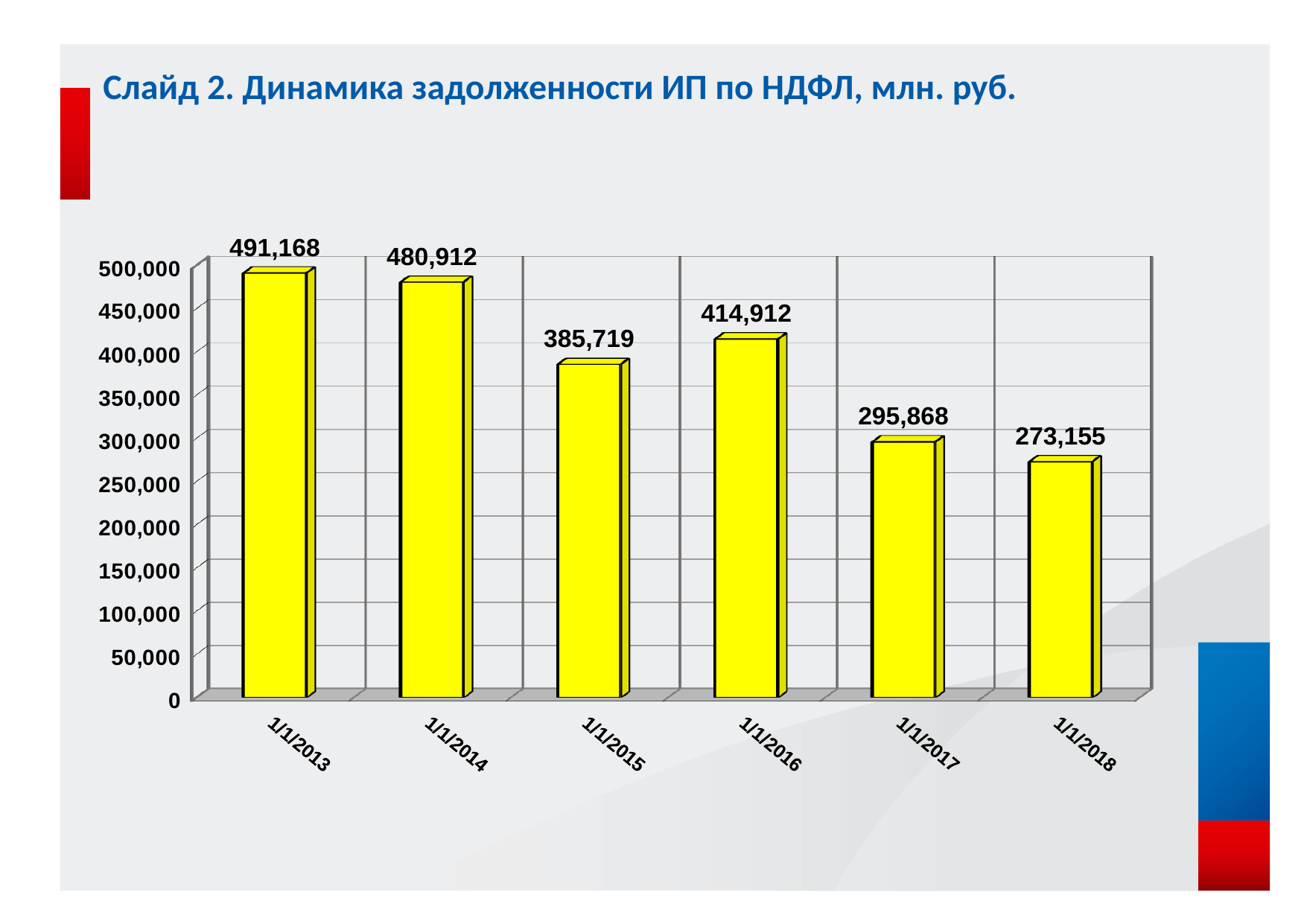
Is the value for 1/1/2017 greater or less than 300,000? less Which date has the highest value? 1/1/2013 What kind of chart is shown on the slide? bar chart What is the value for 1/1/2018? 273,155 What is the value for 1/1/2016? 414,912 Overall, do the values rise or fall from 1/1/2013 to 1/1/2018? fall Which is larger, the value for 1/1/2015 or the value for 1/1/2016? 1/1/2016 How many bars are shown in the chart? 6 What is the difference between the values for 1/1/2016 and 1/1/2015? 29,193 Which date has the lowest value? 1/1/2018 What is the difference between the values for 1/1/2013 and 1/1/2014? 10,256 What is the value for 1/1/2013? 491,168